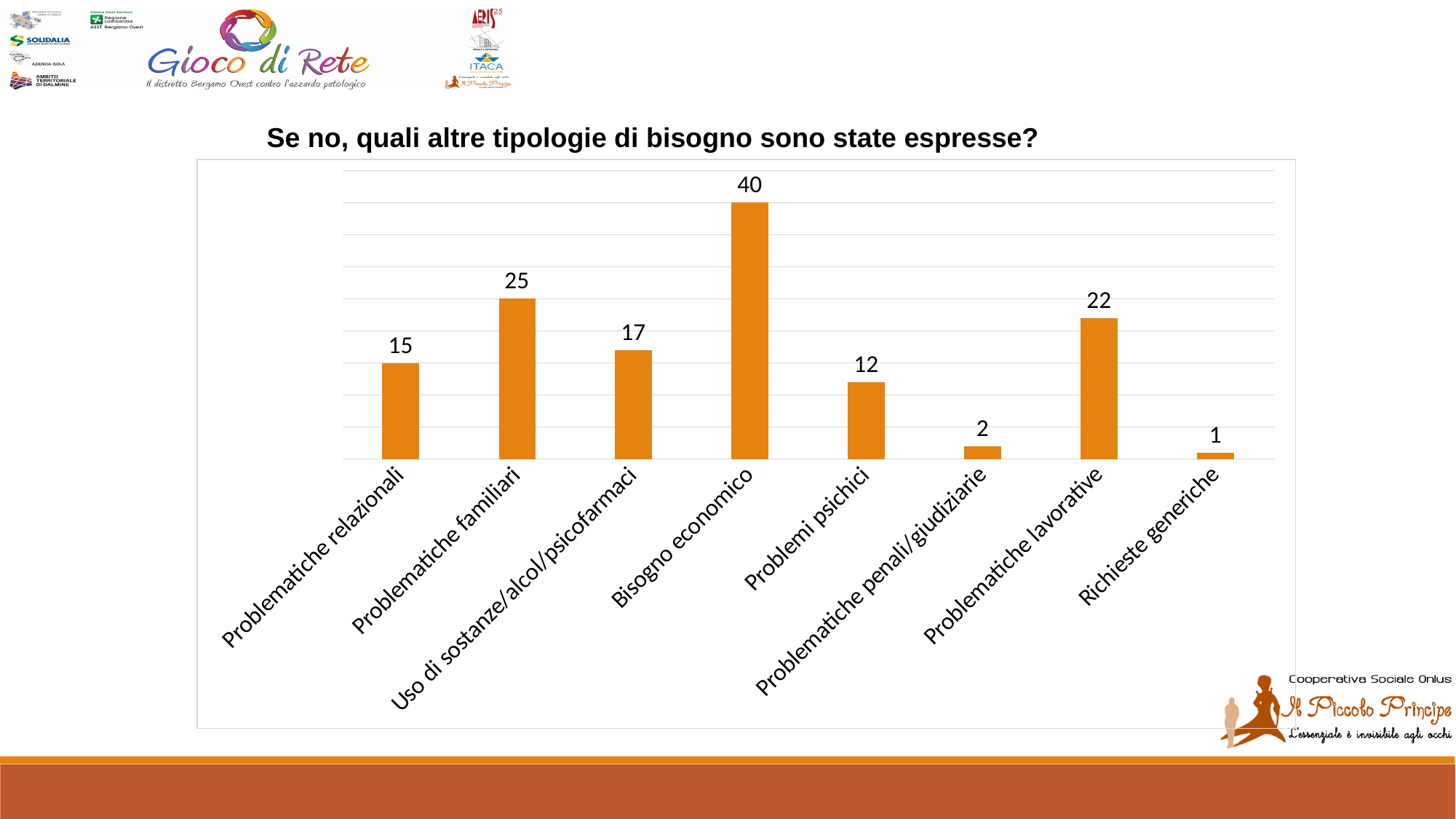
What is the difference between Problematiche familiari and Problematiche relazionali? 10 Which category has the lowest value? Richieste generiche Which is larger, Problematiche lavorative or Problematiche familiari? Problematiche familiari What is the title of the chart? Se no, quali altre tipologie di bisogno sono state espresse? What is the value for Problematiche penali/giudiziarie? 2 Which category has the highest value? Bisogno economico What is the value for Bisogno economico? 40 How many categories are shown in the chart? 8 What is the value for Uso di sostanze/alcol/psicofarmaci? 17 What kind of chart is shown on the slide? Bar chart What is the difference between Bisogno economico and Problemi psichici? 28 What is the value for Problematiche lavorative? 22